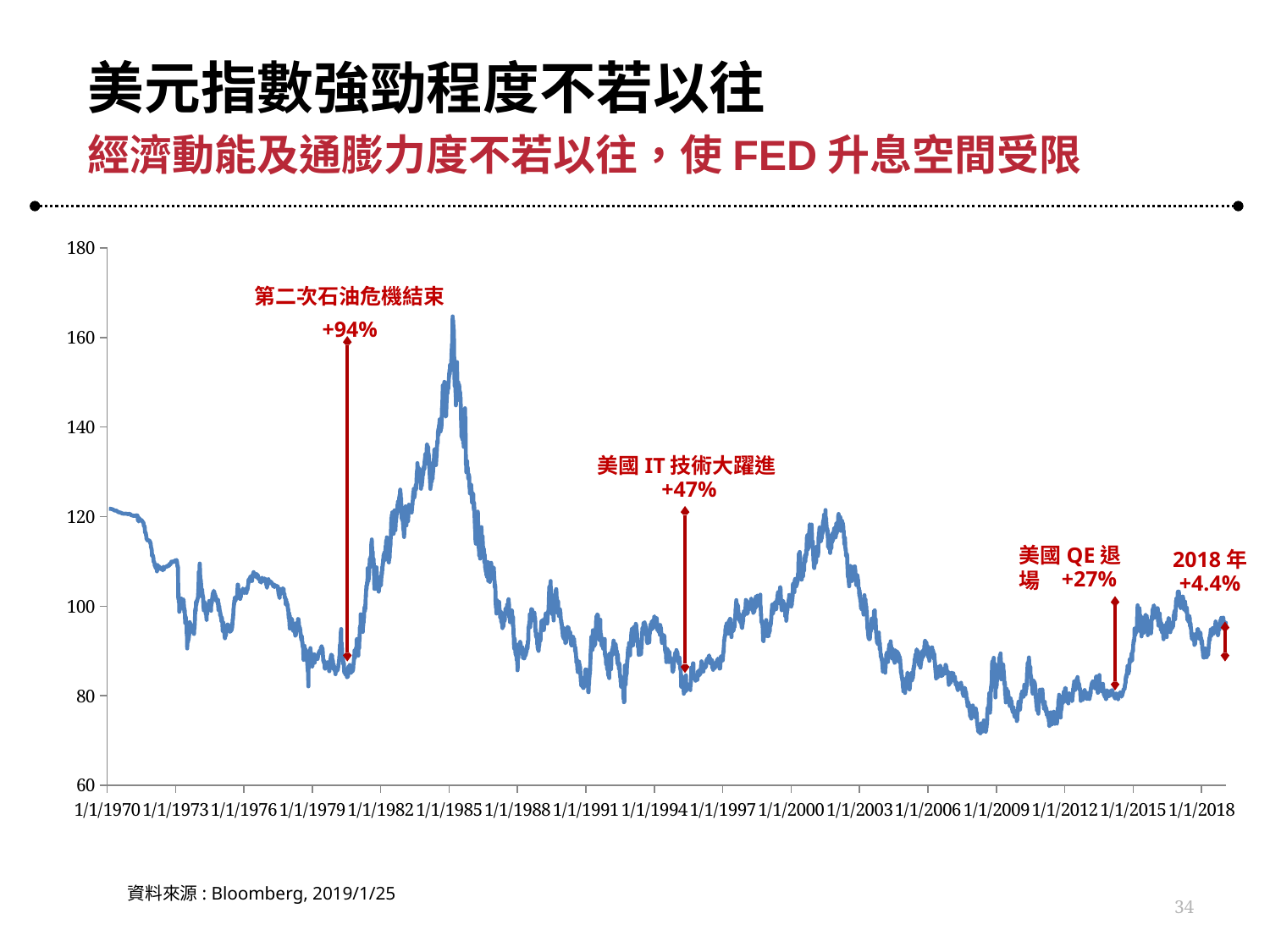
Is the peak value of the index around 1/1/1985 greater or less than 160? greater What kind of chart is shown on the slide? line chart Does the index rise or fall between 1/1/1985 and 1/1/1988? fall Is the lowest value of the index around 2008 greater or less than 80? less Which annotated rally has the smallest labelled percentage gain? 2018 年 (+4.4%) What percentage gain is labelled for the period annotated 美國 IT 技術大躍進? +47% What percentage gain is labelled for 2018 年? +4.4% What percentage gain is labelled for the period annotated 美國 QE 退場? +27% How many percentage points larger is the +94% gain than the +47% gain? 47 percentage points What percentage gain is labelled for the period annotated 第二次石油危機結束? +94% Which annotated rally has the largest labelled percentage gain? 第二次石油危機結束 (+94%) Which labelled gain is larger, 美國 IT 技術大躍進 or 美國 QE 退場? 美國 IT 技術大躍進